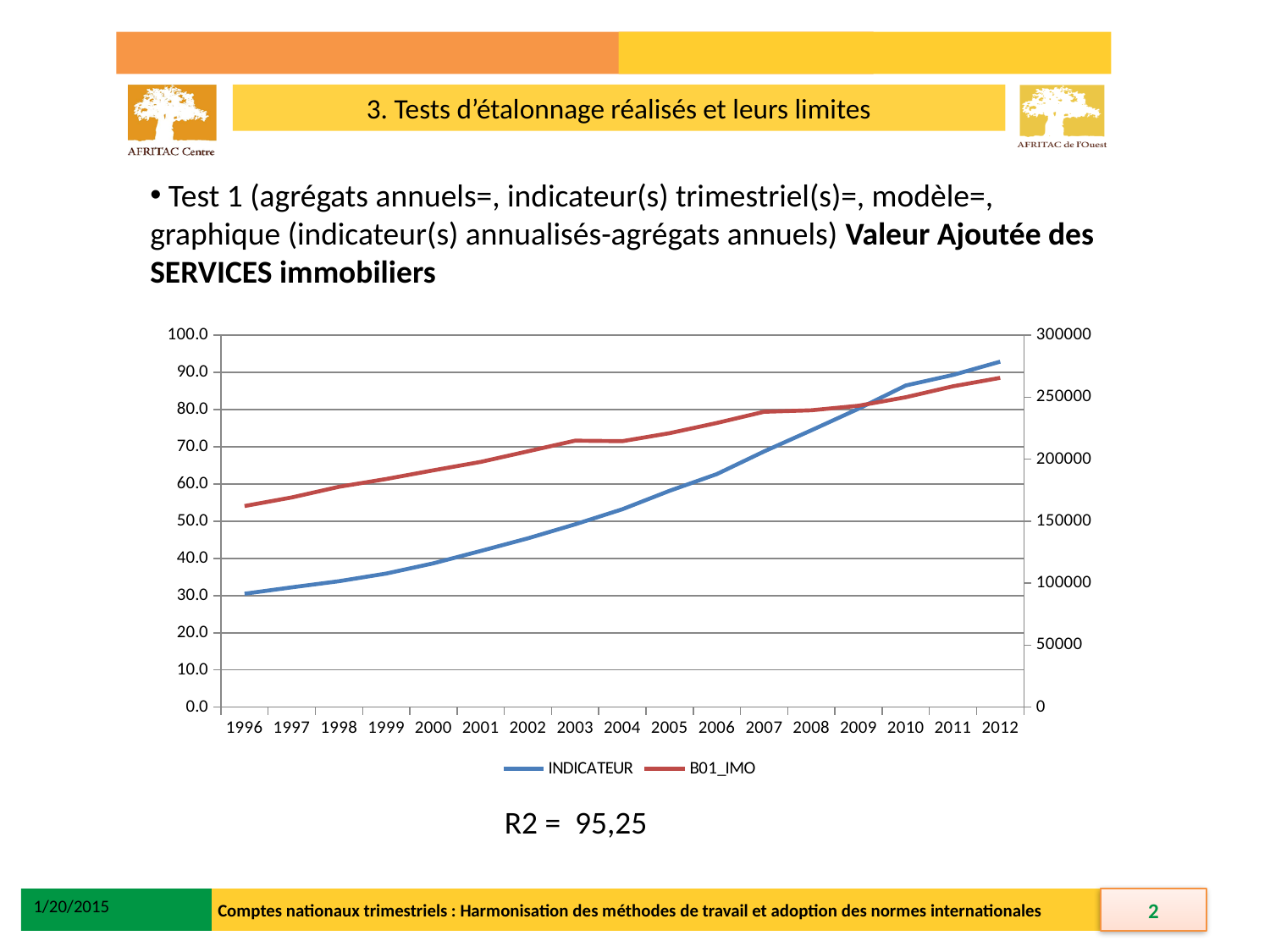
In which year is the B01_IMO series at its lowest? 1996 Does the INDICATEUR series rise or fall from 1996 to 2012? rise How many series does the legend list? 2 How many years are shown on the x axis? 17 Is the INDICATEUR value for 2010 greater or less than 80? greater Is the B01_IMO value for 2007 greater or less than 250000? less In which year is the INDICATEUR series at its highest? 2012 Is the B01_IMO value for 2012 greater or less than 250000? greater What is the first year shown on the x axis? 1996 What are the names of the two series in the legend? INDICATEUR and B01_IMO What kind of chart is shown on the slide? line chart